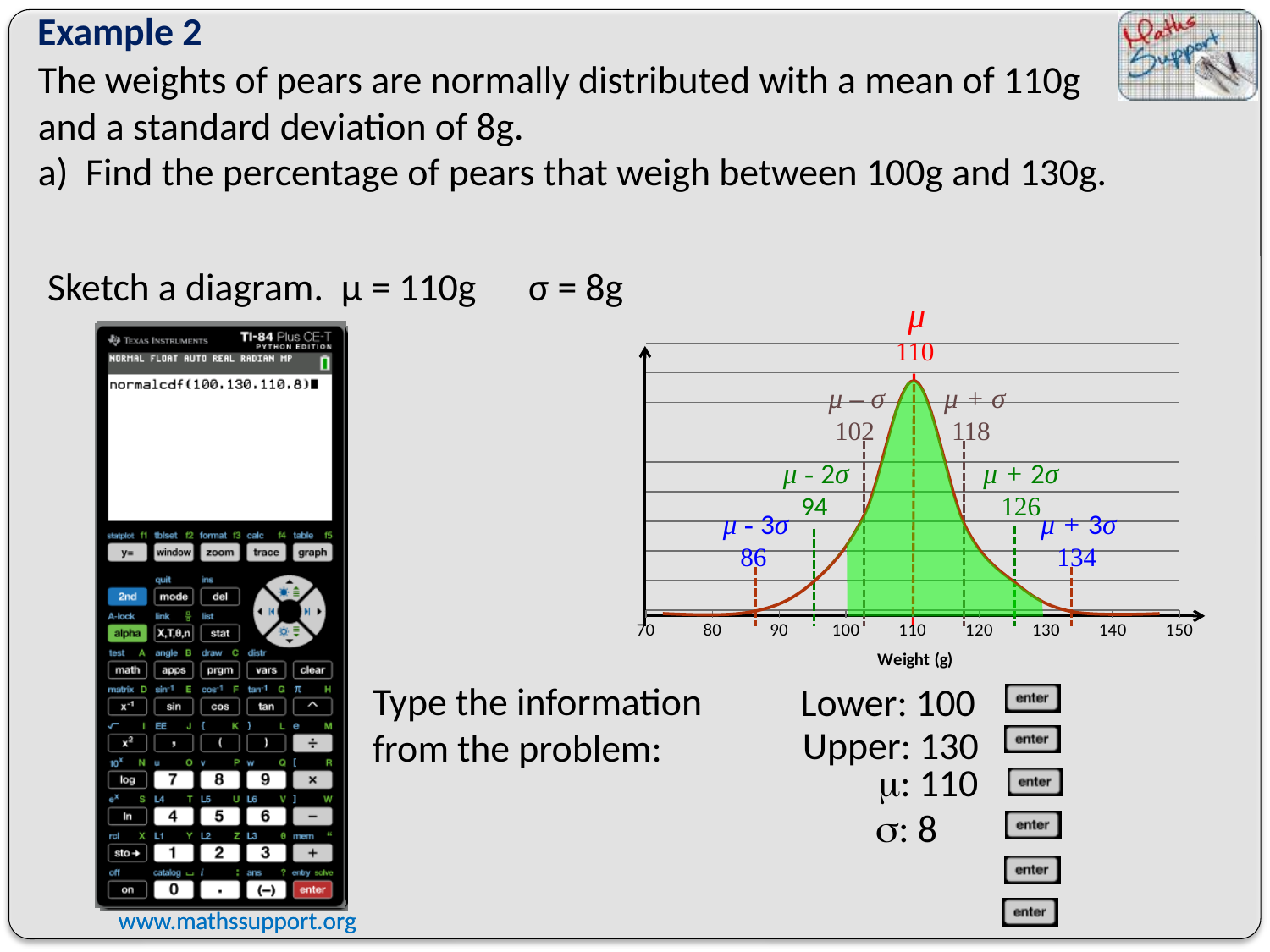
What weight value is labelled at the mean μ on the chart? 110 What kind of chart is shown on the slide? line chart How many tick labels are shown on the horizontal axis of the chart? 9 What weight value is labelled at μ − 2σ on the chart? 94 What is the difference between the values labelled at μ + σ and μ − σ on the chart? 16 What weight value is labelled at μ + σ on the chart? 118 What is the title of the horizontal axis on the chart? Weight (g) What weight value is labelled at μ + 3σ on the chart? 134 What is the difference between the values labelled at μ + 3σ and μ on the chart? 24 What weight value is labelled at μ − 3σ on the chart? 86 Does the curve rise or fall as weight increases from 110 to 150? fall Between which two weights is the region under the curve shaded green? 100 and 130